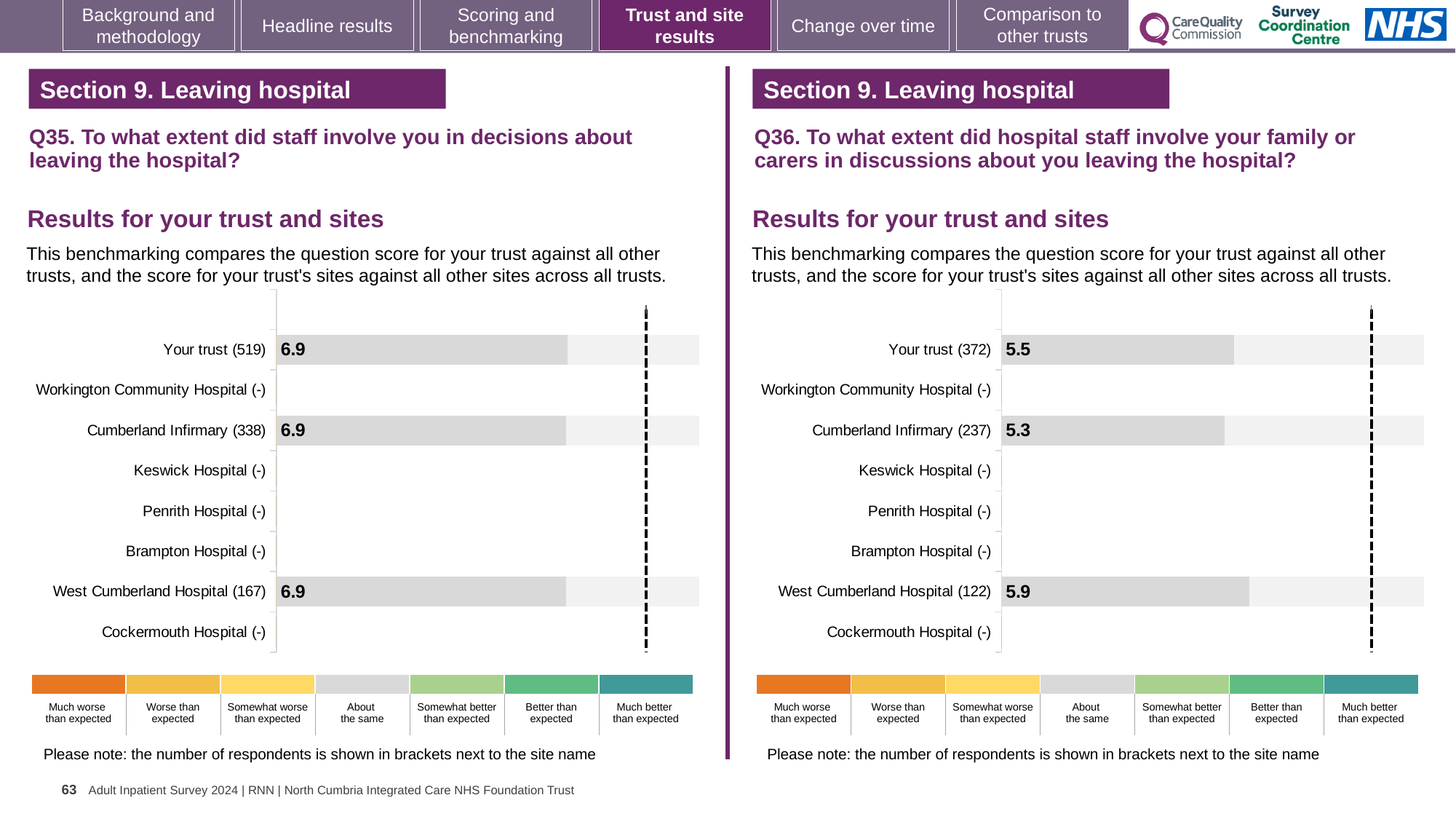
In the Q36 chart on the right, what is the score for West Cumberland Hospital? 5.9 In the Q36 chart on the right, which site has the highest score? West Cumberland Hospital In the Q36 chart on the right, which is larger: the score for Your trust or the score for Cumberland Infirmary? Your trust In the Q35 chart on the left, what is the score for West Cumberland Hospital? 6.9 What kind of chart is used in the Q36 chart on the right? Bar chart In the Q36 chart on the right, which site has the lowest score? Cumberland Infirmary In the Q36 chart on the right, what is the score for Your trust? 5.5 In the Q36 chart on the right, what is the score for Cumberland Infirmary? 5.3 How many site rows (excluding Your trust) are listed in the Q35 chart on the left? 7 In the Q36 chart on the right, what is the difference between the scores for West Cumberland Hospital and Cumberland Infirmary? 0.6 How many respondents are shown in brackets for Your trust in the Q35 chart on the left? 519 In the Q35 chart on the left, what is the score for Your trust? 6.9